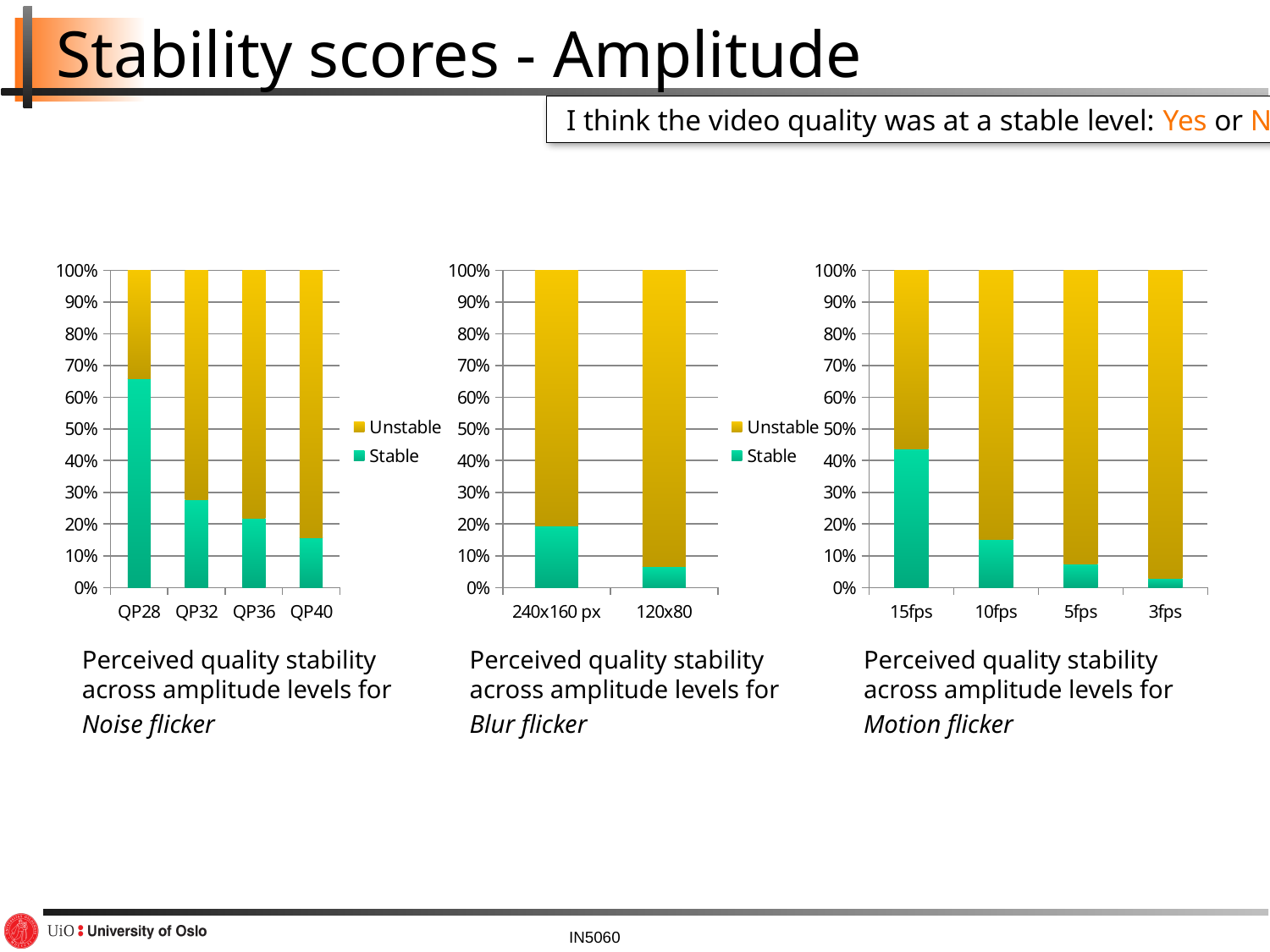
In the Noise flicker chart, how many categories are shown on the x axis? 4 In the Motion flicker chart, which category has the smallest Stable share? 3fps In the Motion flicker chart, is the Stable share for 15fps greater or less than 30%? greater In the Noise flicker chart, does the Stable share rise or fall from QP28 to QP40? fall What kind of chart is the Noise flicker chart on the left? bar chart In the Noise flicker chart, is the Stable share for QP28 greater or less than 60%? greater In the Noise flicker chart, which category has the largest Stable share? QP28 In the Noise flicker chart, how many series does the legend list? 2 In the Blur flicker chart, how many categories are shown on the x axis? 2 In the Blur flicker chart, is the Stable share for 120x80 greater or less than 10%? less In the Blur flicker chart, which has the larger Stable share, 240x160 px or 120x80? 240x160 px In the Motion flicker chart, what is the total of the stacked bar for 10fps? 100%